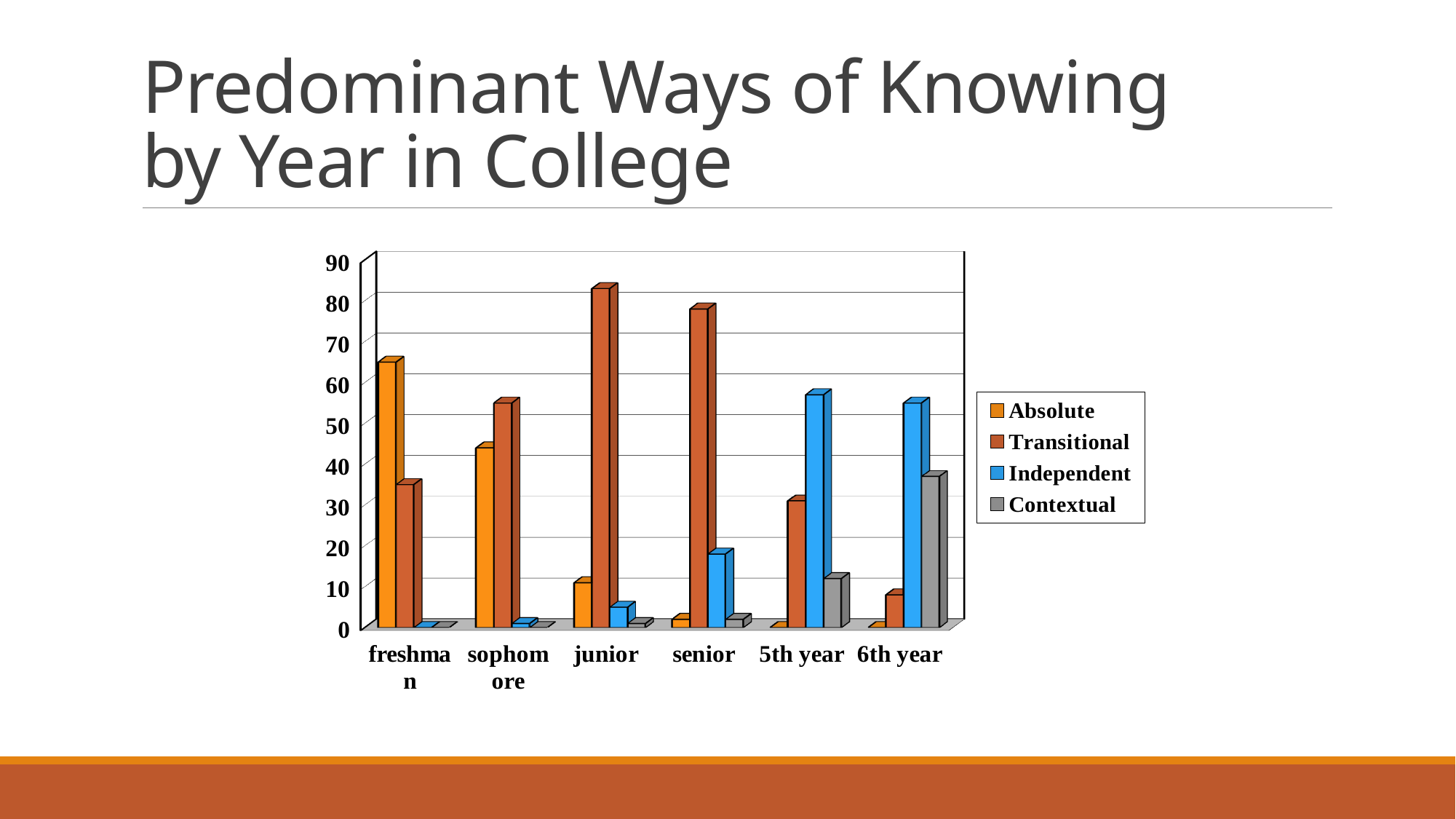
Which year has the highest Transitional value? junior For freshman, which is larger: Absolute or Transitional? Absolute Is the Transitional value for junior greater or less than 70? greater Is the Absolute value for freshman greater or less than 60? greater For 5th year, which is larger: Independent or Transitional? Independent Is the Contextual value for 6th year greater or less than 30? greater Which year has the highest Absolute value? freshman How many year-in-college categories are shown on the x axis? 6 What kind of chart is shown on the slide? bar chart Do the Absolute values rise or fall from freshman to 6th year? fall Which year has the lowest Transitional value? 6th year How many series does the legend list? 4